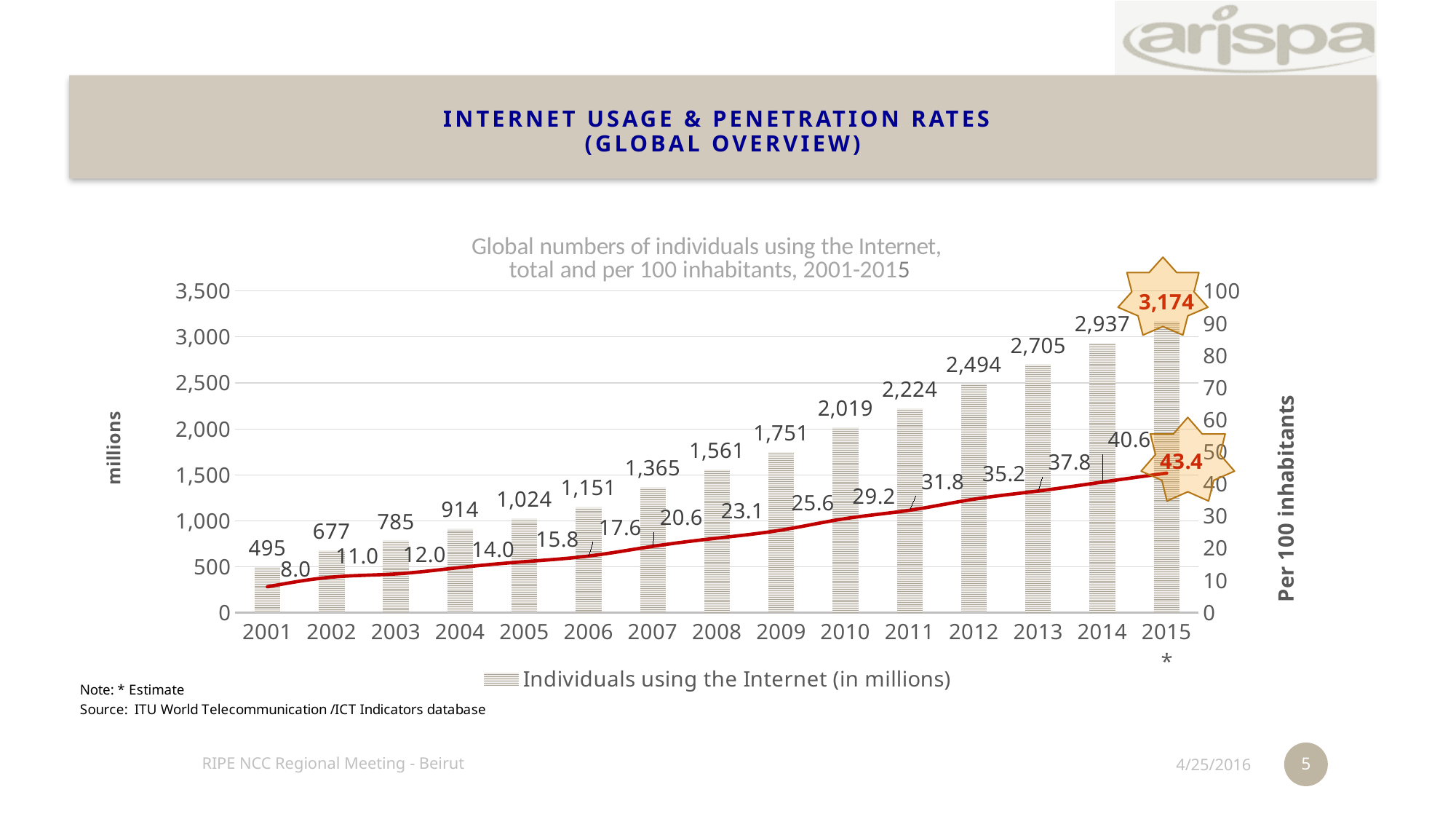
What is the difference in millions of Internet users between 2014 and 2013? 232 Which year has more Internet users in millions, 2005 or 2008? 2008 Which year has the highest per 100 inhabitants value? 2015 What type of chart is used to show the individuals using the Internet in millions? Bar chart What is the title of the chart? Global numbers of individuals using the Internet, total and per 100 inhabitants, 2001-2015 Which year has the lowest number of individuals using the Internet? 2001 What is the per 100 inhabitants value for 2007? 20.6 What is the label of the right-hand vertical axis? Per 100 inhabitants Do the numbers of individuals using the Internet rise or fall from 2001 to 2015? Rise How many individuals (in millions) were using the Internet in 2010? 2,019 What is the estimated number of individuals using the Internet (in millions) in 2015? 3,174 How many years are shown on the x axis? 15